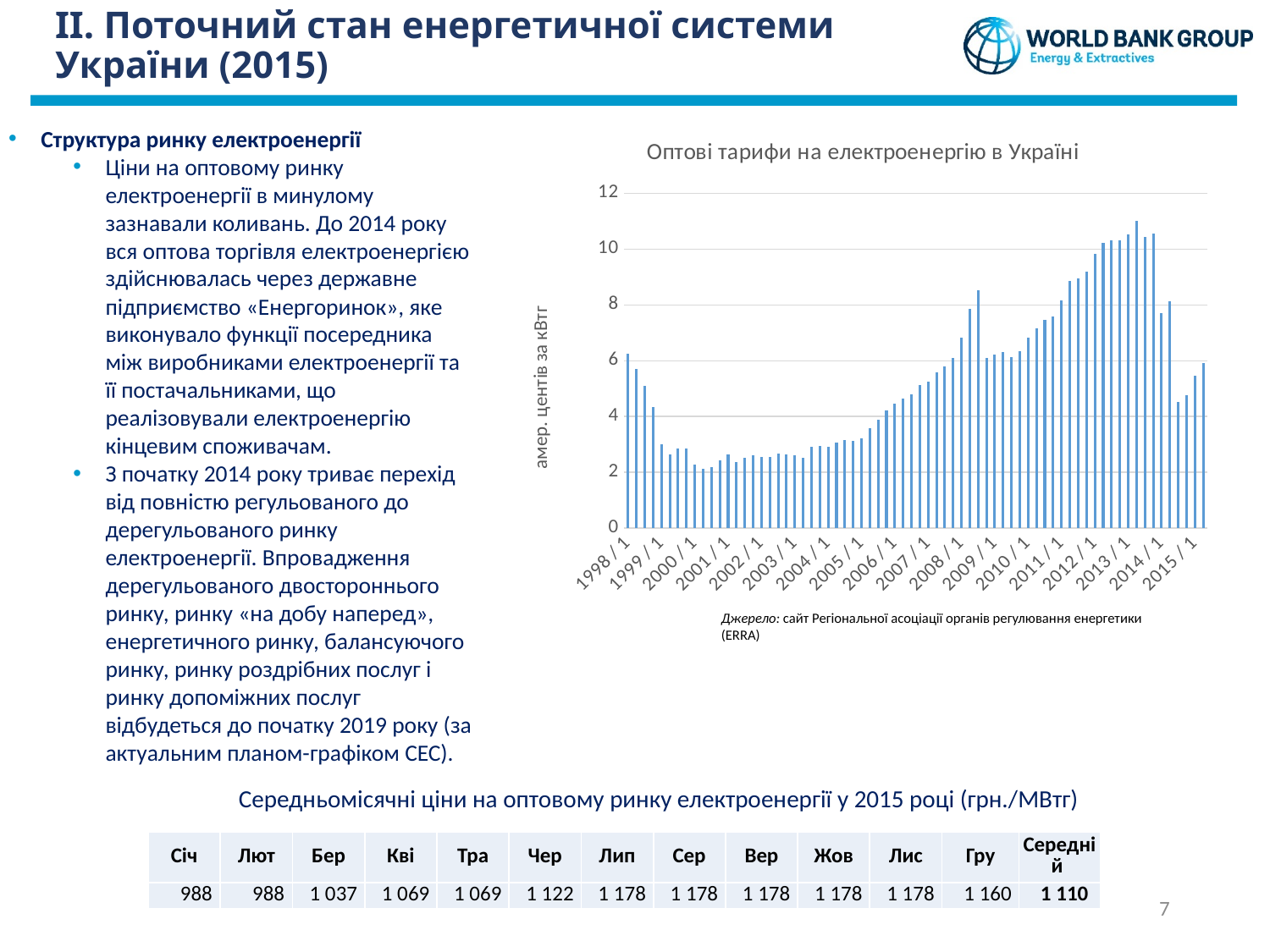
Is the value for 2001 / 1 greater or less than 4? less What is the title of the chart on the slide? Оптові тарифи на електроенергію в Україні Do the values rise or fall between 2013 / 1 and 2015 / 1? fall Is the value for 2013 / 1 greater or less than 8? greater What is the label of the vertical axis of the chart? амер. центів за кВтг Do the values generally rise or fall between 2001 / 1 and 2013 / 1? rise Is the value for 1998 / 1 greater or less than 4? greater Which is larger, the value for 2012 / 1 or the value for 2005 / 1? 2012 / 1 What kind of chart is "Оптові тарифи на електроенергію в Україні"? bar chart Which is larger, the value for 1998 / 1 or the value for 2001 / 1? 1998 / 1